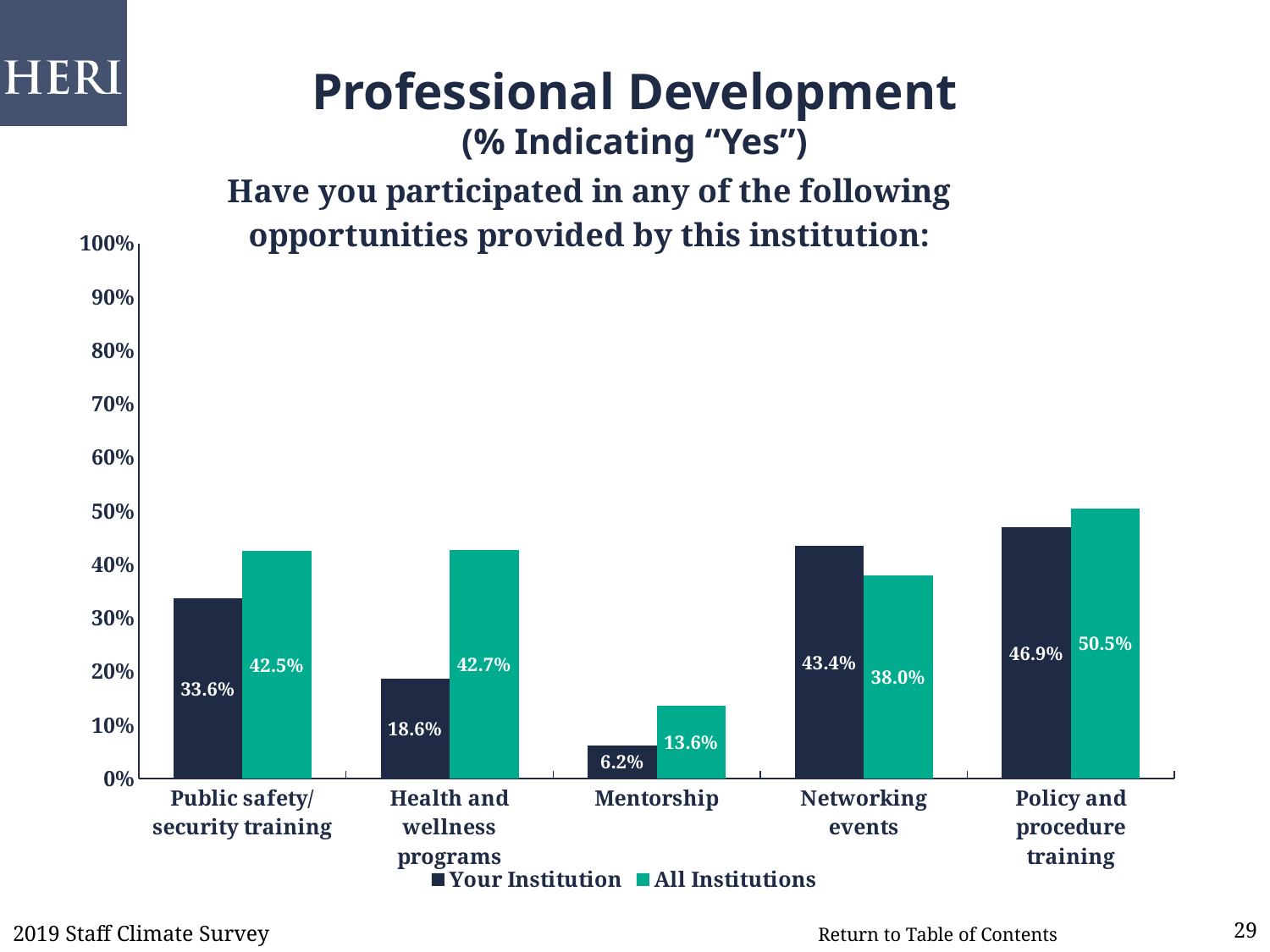
For Networking events, which series has the larger value, Your Institution or All Institutions? Your Institution How many series does the legend list? 2 What is the value for Your Institution for Mentorship? 6.2% What kind of chart is shown on the slide? Bar chart What is the value for All Institutions for Policy and procedure training? 50.5% What is the difference between All Institutions and Your Institution for Health and wellness programs? 24.1% What is the title of the chart? Have you participated in any of the following opportunities provided by this institution: What is the value for Your Institution for Networking events? 43.4% Is the value for Your Institution for Public safety/security training greater or less than 40%? less Which category has the lowest value for Your Institution? Mentorship Which category has the highest value for All Institutions? Policy and procedure training How many categories are shown on the x axis? 5